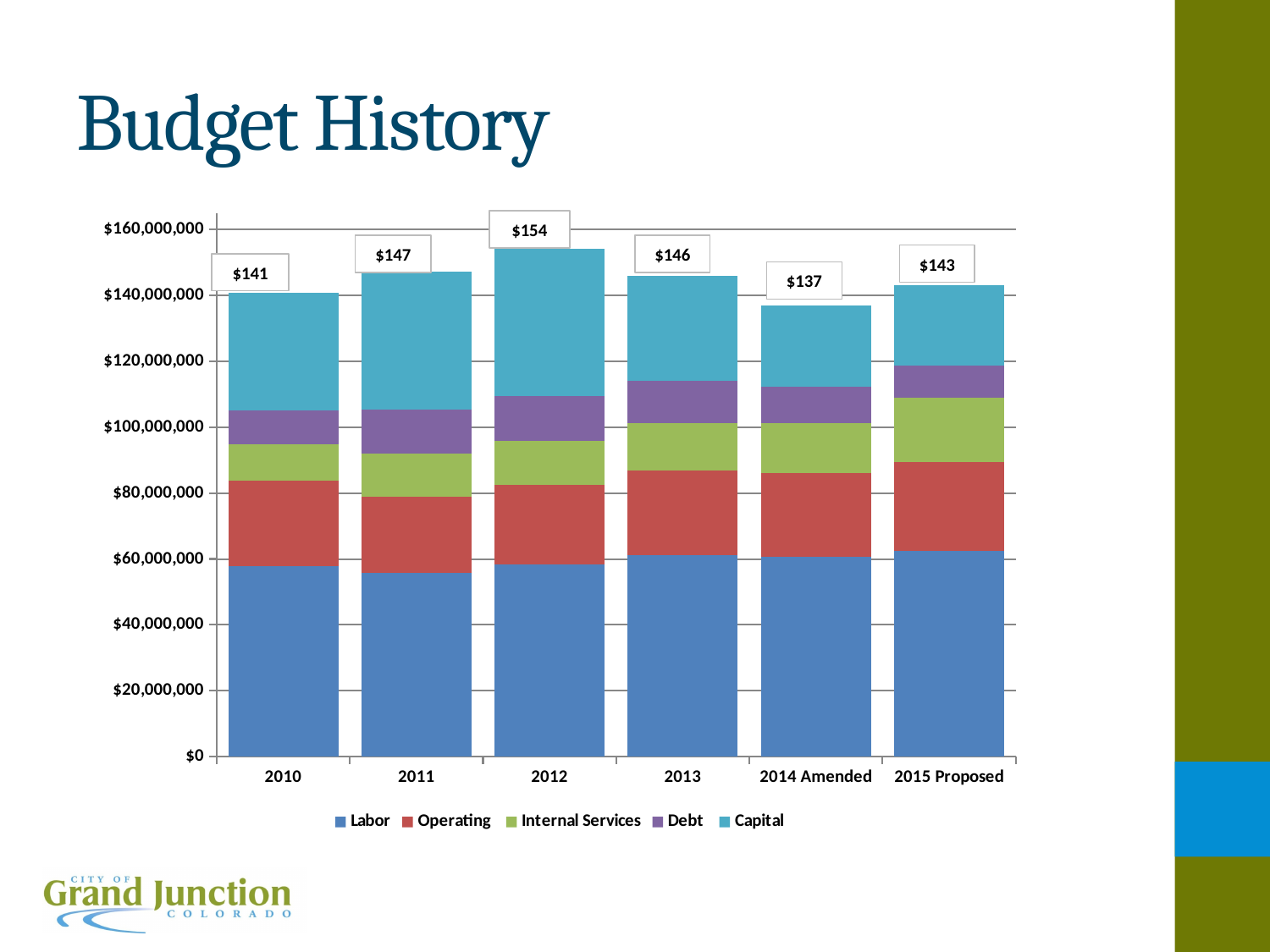
What is the total budget label shown for 2014 Amended? $137 How many series does the legend list? 5 What is the difference between the total budget labels for 2012 and 2014 Amended? $17 How many years (categories) are shown on the x axis? 6 Do the total budget values rise or fall from 2010 to 2012? rise What is the total budget label shown for 2012? $154 Which year has the lowest total budget? 2014 Amended Which year has the highest total budget? 2012 Is the total for 2014 Amended greater or less than $140,000,000? less Which has a larger total budget, 2011 or 2013? 2011 What kind of chart is shown on the slide? stacked bar chart What is the total budget label shown for 2015 Proposed? $143